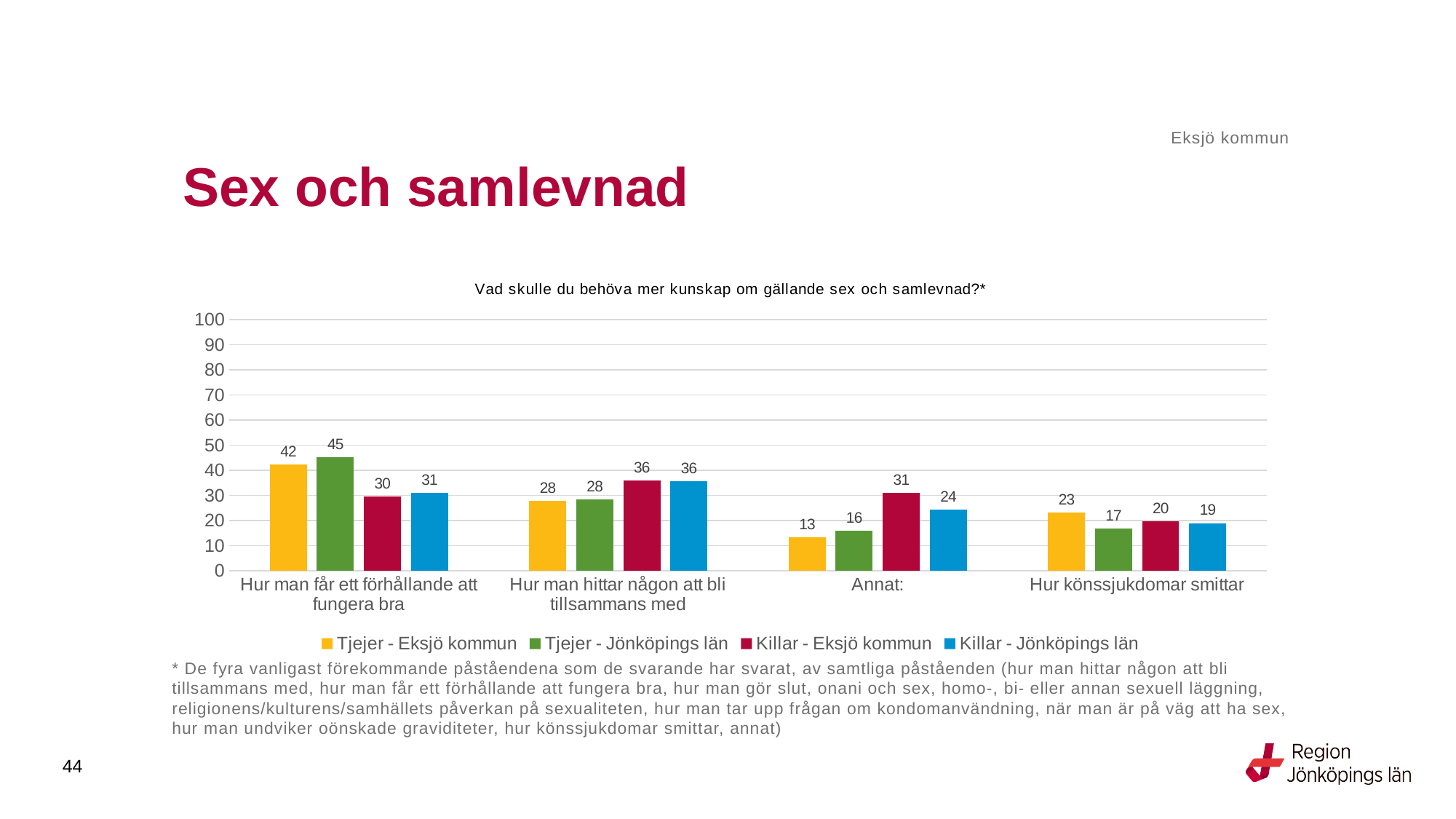
What is the value for Tjejer - Jönköpings län in the category "Hur könssjukdomar smittar"? 17 Which series has the highest value in the category "Hur man får ett förhållande att fungera bra"? Tjejer - Jönköpings län How many series does the legend list? 4 Which series has the lowest value in the category "Annat:"? Tjejer - Eksjö kommun What is the title of the chart? Vad skulle du behöva mer kunskap om gällande sex och samlevnad?* What is the value for Killar - Jönköpings län in the category "Annat:"? 24 What is the difference between Killar - Eksjö kommun and Tjejer - Eksjö kommun in the category "Annat:"? 18 How many categories are shown on the x axis? 4 Which is larger in the category "Hur könssjukdomar smittar": Tjejer - Eksjö kommun or Killar - Eksjö kommun? Tjejer - Eksjö kommun What is the value for Tjejer - Eksjö kommun in the category "Hur man får ett förhållande att fungera bra"? 42 Is the value for Killar - Eksjö kommun in "Hur man hittar någon att bli tillsammans med" greater or less than 30? greater What kind of chart is shown on the slide? Bar chart